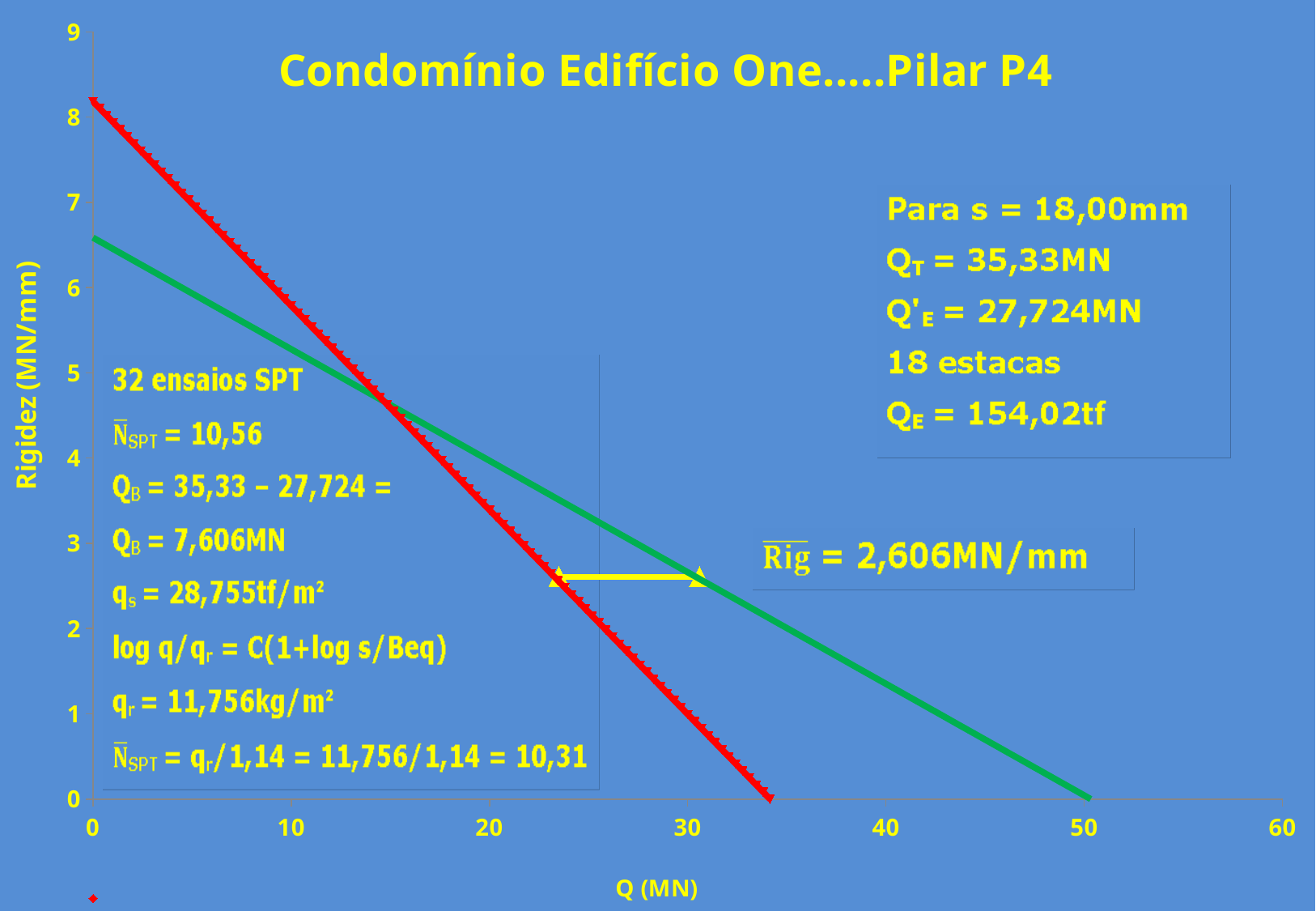
How many lines are plotted on the chart? 2 At Q = 40 MN, which line has the higher Rigidez value, the red line or the green line? green line What is the label of the y axis? Rigidez (MN/mm) Do the values of the red line rise or fall as Q increases along the x axis? fall What kind of chart is shown on the slide? line chart Is the value of the green line at Q = 0 greater or less than 6 MN/mm? greater Is the value of the red line at Q = 20 MN greater or less than 4 MN/mm? less Is the value of the green line at Q = 40 MN greater or less than 2 MN/mm? less What is the title of the chart? Condomínio Edifício One.....Pilar P4 Do the values of the green line rise or fall as Q increases along the x axis? fall At Q = 0, which line has the higher Rigidez value, the red line or the green line? red line